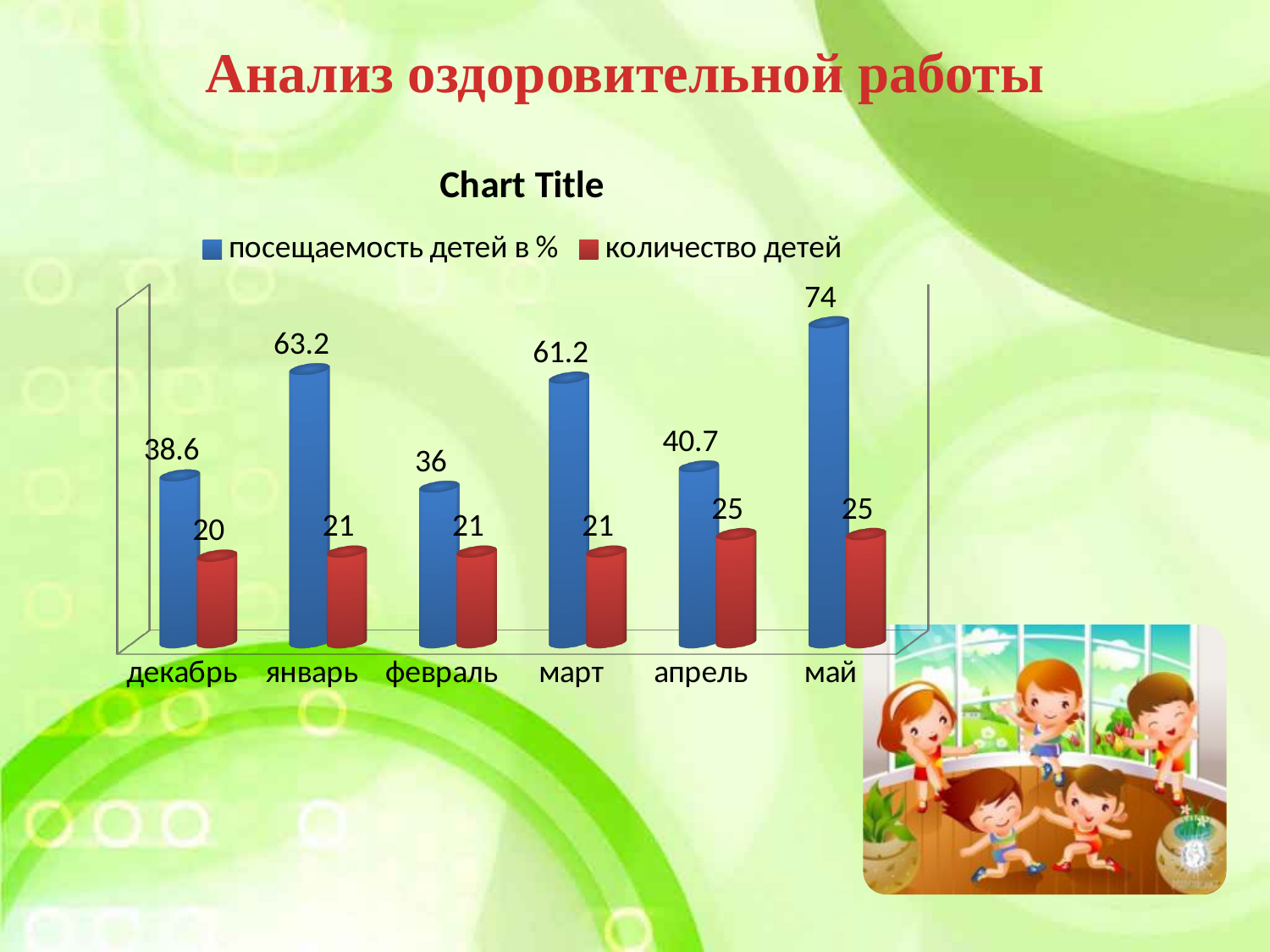
What kind of chart is shown on the slide? bar chart What is the difference between посещаемость детей в % in май and in март? 12.8 What is the value of количество детей for апрель? 25 How many series does the legend list? 2 Which month has the lowest количество детей? декабрь How many months are shown on the x axis? 6 What is the value of посещаемость детей в % for январь? 63.2 Which is larger: посещаемость детей в % in январь or in апрель? январь Which colour represents количество детей in the chart? red Which month has the lowest посещаемость детей в %? февраль Which month has the highest посещаемость детей в %? май What is the value of посещаемость детей в % for декабрь? 38.6